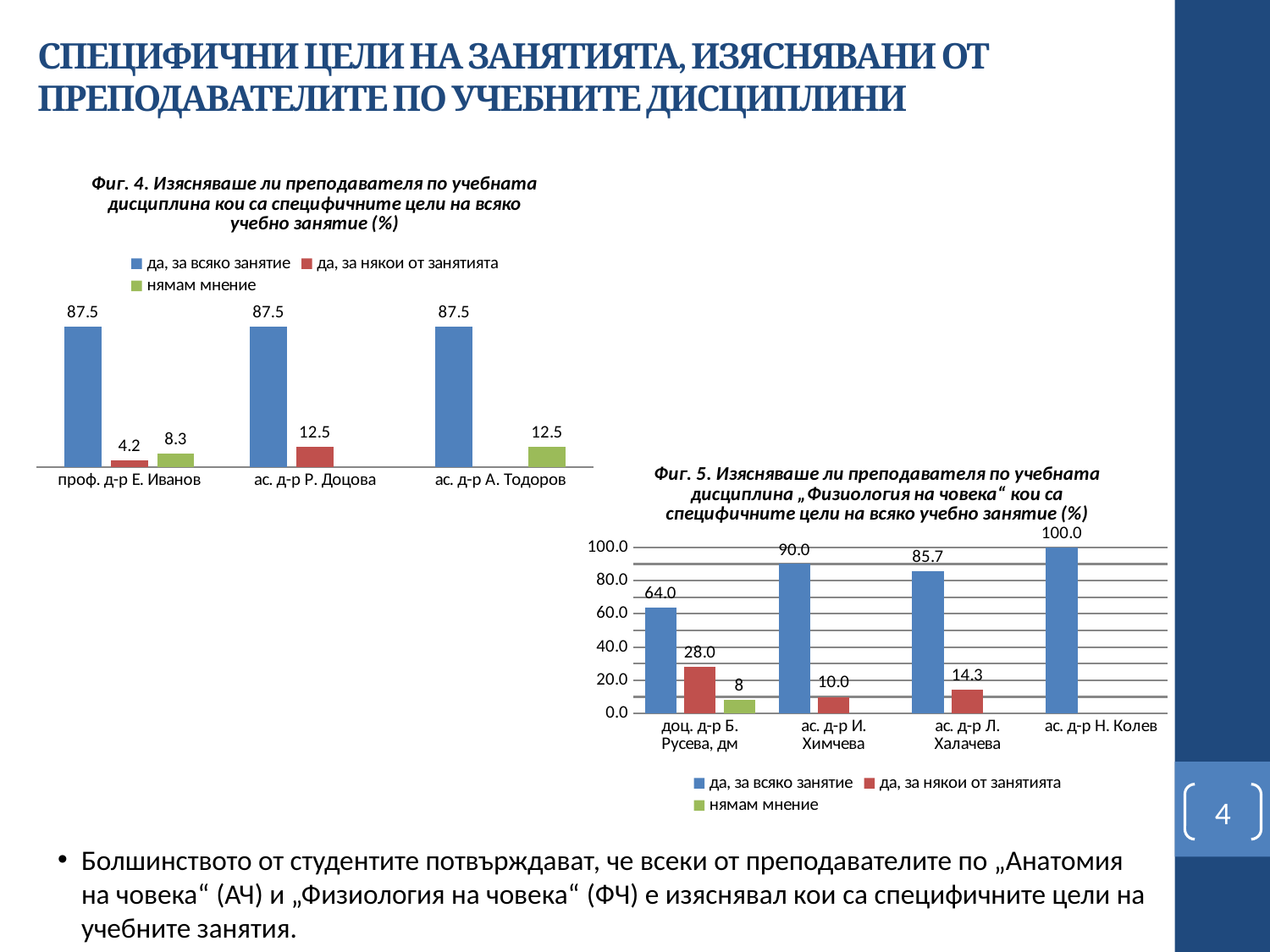
In Фиг. 5, what is the value of "да, за всяко занятие" for ас. д-р Н. Колев? 100.0 In Фиг. 4, how many series does the legend list? 3 What type of chart is Фиг. 5? bar chart In Фиг. 4, what is the value of "да, за някои от занятията" for ас. д-р Р. Доцова? 12.5 In Фиг. 4, what is the value of "нямам мнение" for проф. д-р Е. Иванов? 8.3 In Фиг. 5, which lecturer has the highest value for "да, за всяко занятие"? ас. д-р Н. Колев In Фиг. 5, which lecturer has the lowest value for "да, за всяко занятие"? доц. д-р Б. Русева, дм In Фиг. 4, what is the difference between the "нямам мнение" value and the "да, за някои от занятията" value for проф. д-р Е. Иванов? 4.1 In Фиг. 5, how many lecturers (categories) are shown on the x axis? 4 In Фиг. 5, what is the difference between the "да, за всяко занятие" values for ас. д-р И. Химчева and ас. д-р Л. Халачева? 4.3 In Фиг. 4, what is the value of "да, за всяко занятие" for проф. д-р Е. Иванов? 87.5 In Фиг. 5, what is the value of "да, за някои от занятията" for доц. д-р Б. Русева, дм? 28.0